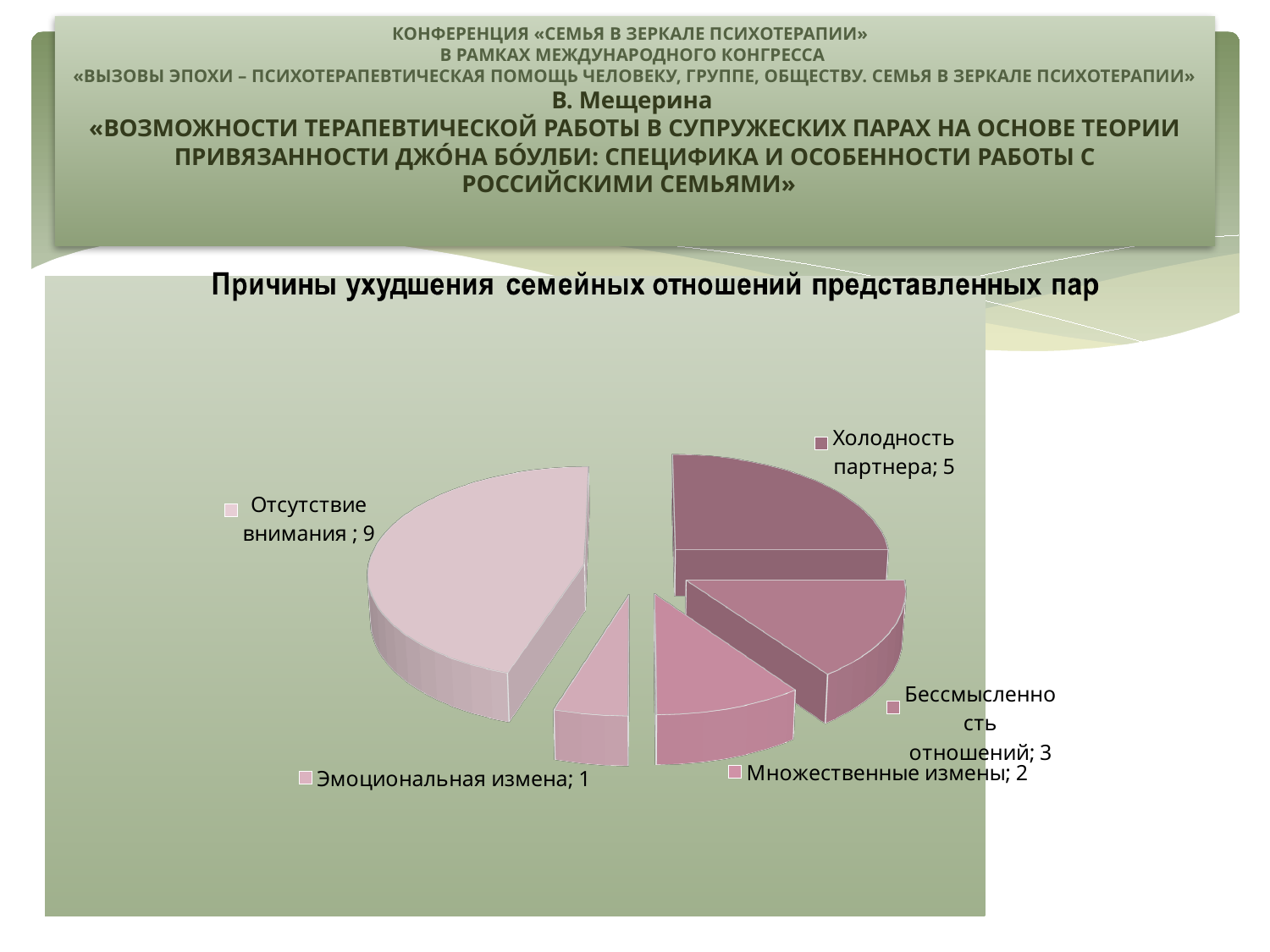
What is the value for «Множественные измены» in the pie chart? 2 How many categories are shown in the pie chart? 5 What is the value for «Холодность партнера» in the pie chart? 5 Which category has the largest slice in the pie chart? Отсутствие внимания What is the title of the chart? Причины ухудшения семейных отношений представленных пар Which category has the smallest slice in the pie chart? Эмоциональная измена What is the value for «Отсутствие внимания» in the pie chart? 9 What share of the pie does «Отсутствие внимания» represent? 45% What type of chart is shown on the slide? Pie chart What is the difference between the values for «Отсутствие внимания» and «Холодность партнера»? 4 Which is larger: «Бессмысленность отношений» or «Множественные измены»? Бессмысленность отношений What is the value for «Бессмысленность отношений» in the pie chart? 3